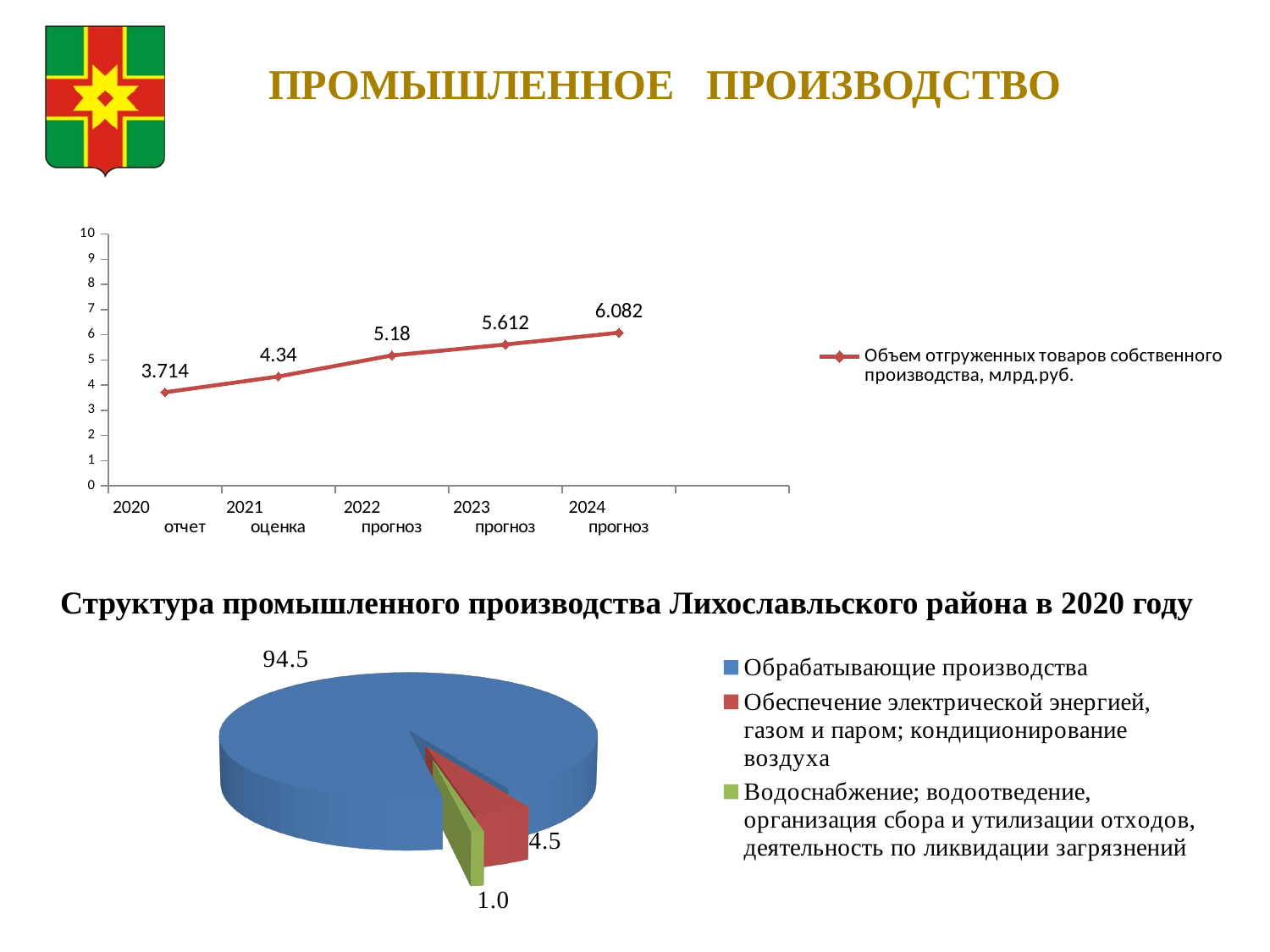
What type of chart is the top chart on the slide? line chart In the top line chart, how many data points are plotted? 5 In the pie chart 'Структура промышленного производства Лихославльского района в 2020 году', which category has the smallest slice? Водоснабжение; водоотведение, организация сбора и утилизации отходов, деятельность по ликвидации загрязнений In the top line chart, do the values rise or fall from 2020 to 2024? rise In the top line chart, which year has the lowest value? 2020 In the pie chart 'Структура промышленного производства Лихославльского района в 2020 году', what is the value for Обрабатывающие производства? 94.5 In the top line chart, what is the value for 2024 (прогноз)? 6.082 In the top line chart, what is the difference between the 2024 value and the 2020 value? 2.368 How many categories does the legend of the pie chart list? 3 In the top line chart, which year has the highest value? 2024 In the top line chart, what is the value for 2020 (отчет)? 3.714 In the top line chart, what is the value for 2022? 5.18